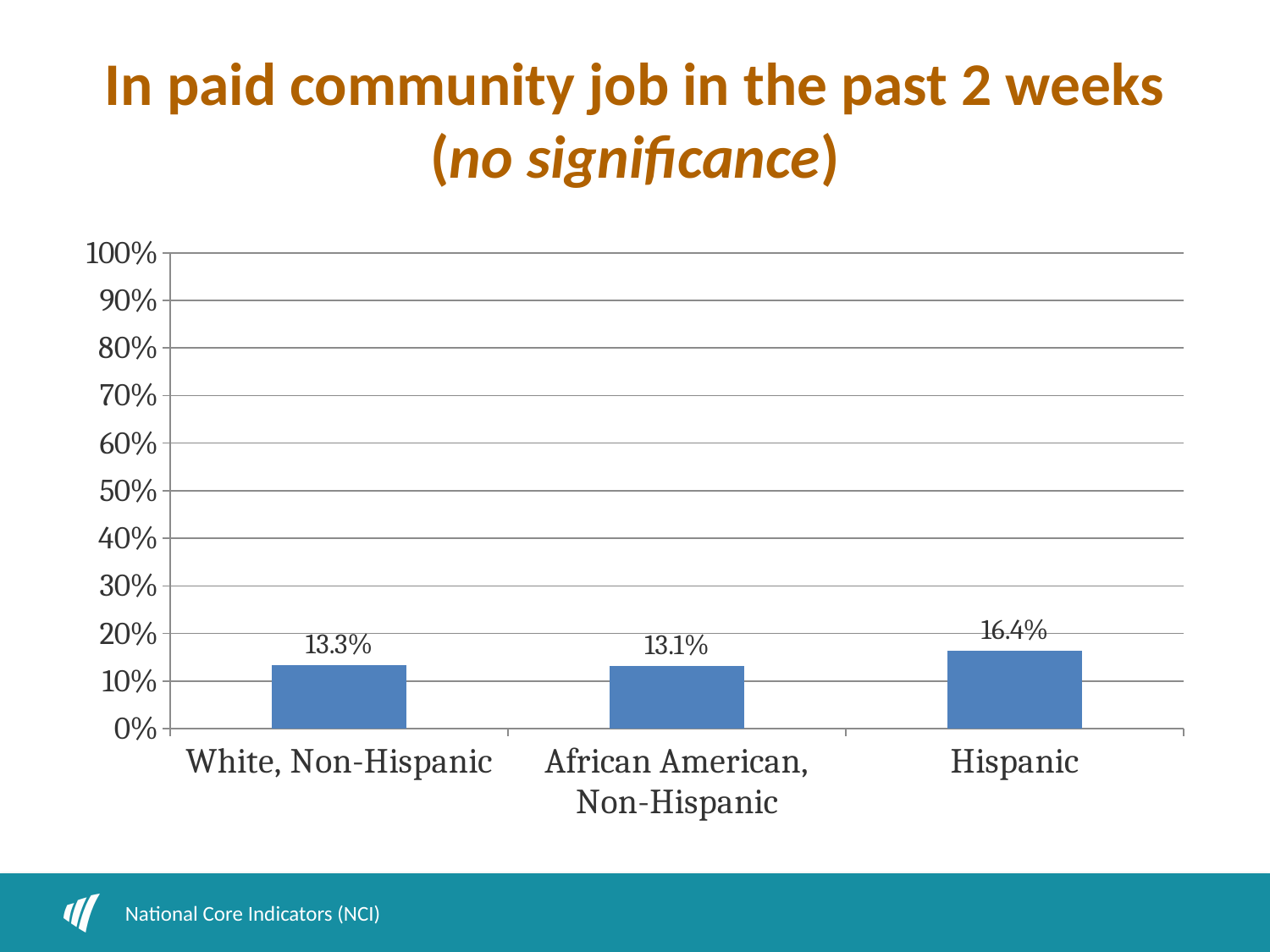
What kind of chart is shown on the slide? bar chart Is the value for Hispanic greater or less than 20%? less What is the value for Hispanic? 16.4% What is the difference between the Hispanic value and the White, Non-Hispanic value? 3.1% Which is larger, the value for Hispanic or the value for African American, Non-Hispanic? Hispanic What is the title of the chart? In paid community job in the past 2 weeks (no significance) How many categories are shown on the x axis? 3 What is the difference between the White, Non-Hispanic value and the African American, Non-Hispanic value? 0.2% What is the value for African American, Non-Hispanic? 13.1% Which category has the highest value? Hispanic Is the value for White, Non-Hispanic greater or less than 10%? greater What is the value for White, Non-Hispanic? 13.3%